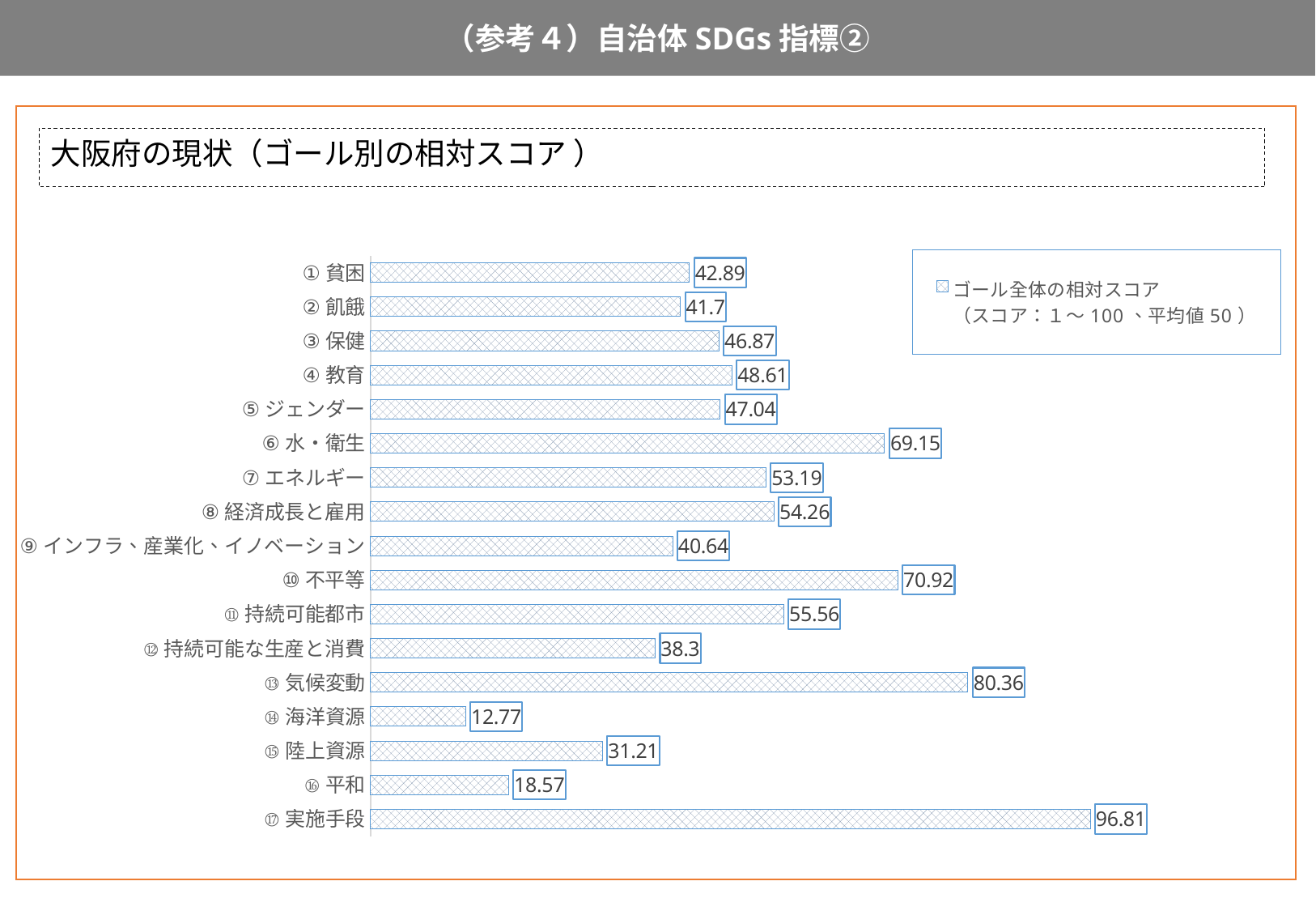
Which goal has the highest relative score? ⑰ 実施手段 What is the legend entry for the series in the chart? ゴール全体の相対スコア（スコア：1～100、平均値50） What is the difference between the scores for ⑬ 気候変動 and ⑯ 平和? 61.79 How many series does the legend list? 1 What is the difference between the scores for ⑰ 実施手段 and ⑭ 海洋資源? 84.04 What is the relative score for ⑨ インフラ、産業化、イノベーション? 40.64 What is the relative score for ⑥ 水・衛生? 69.15 How many goals (categories) are shown in the chart? 17 What kind of chart is shown on the slide? Bar chart What is the relative score for ⑭ 海洋資源? 12.77 Which goal has the lowest relative score? ⑭ 海洋資源 Which has a higher relative score, ⑩ 不平等 or ⑪ 持続可能都市? ⑩ 不平等